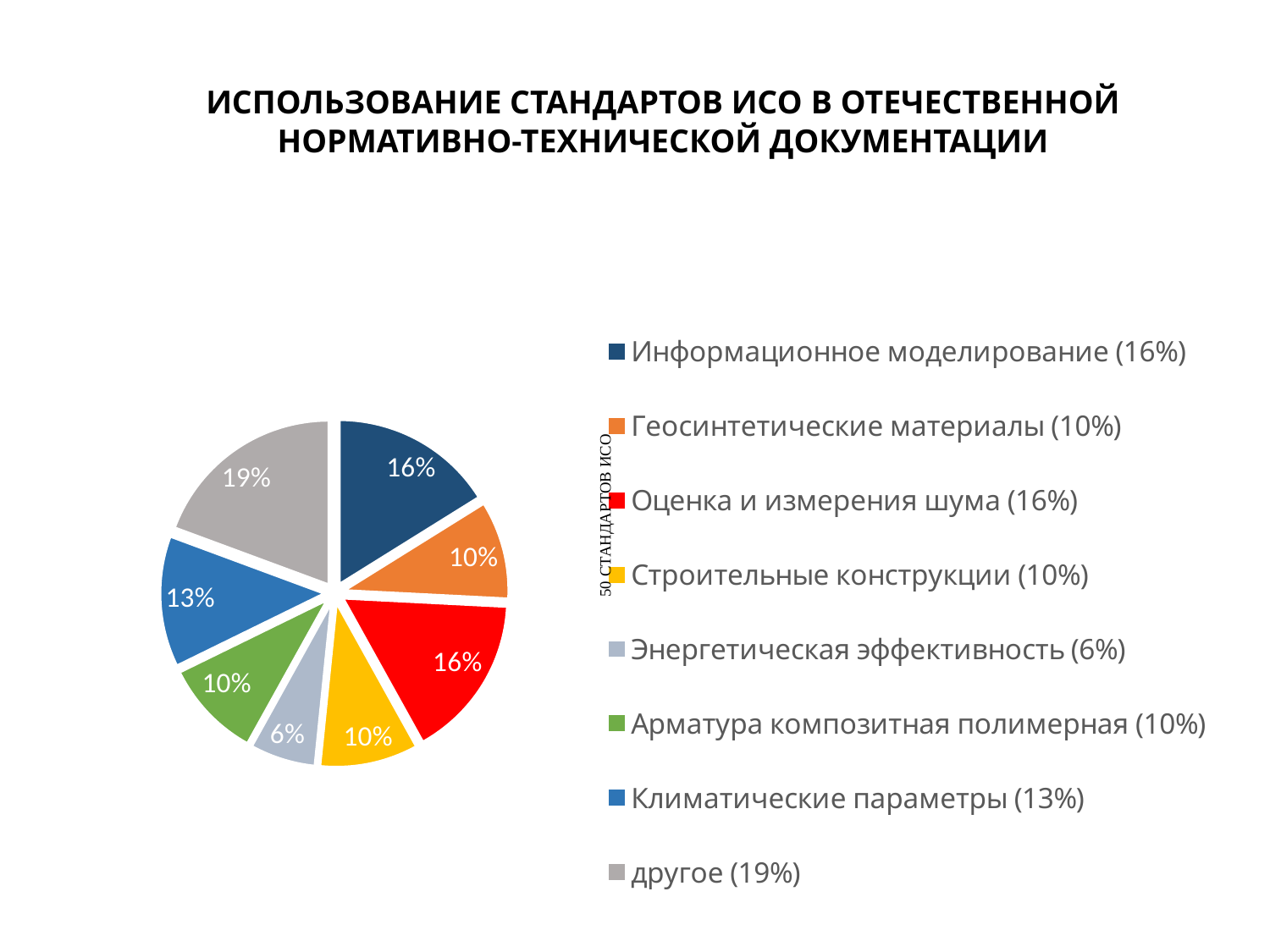
How many slices does the pie chart have? 8 What is the difference in percentage points between "другое" and "Энергетическая эффективность"? 13 What share of the pie does "Климатические параметры" take? 13% What share of the pie does "другое" take? 19% What is the value shown for "Строительные конструкции"? 10% What kind of chart is shown on the slide? pie chart What is the value shown for "Энергетическая эффективность"? 6% How many entries does the legend list? 8 Which category has the smallest slice of the pie? Энергетическая эффективность Which category has the largest slice of the pie? другое Which is larger: the share for "Климатические параметры" or for "Геосинтетические материалы"? Климатические параметры What is the value shown for "Информационное моделирование"? 16%